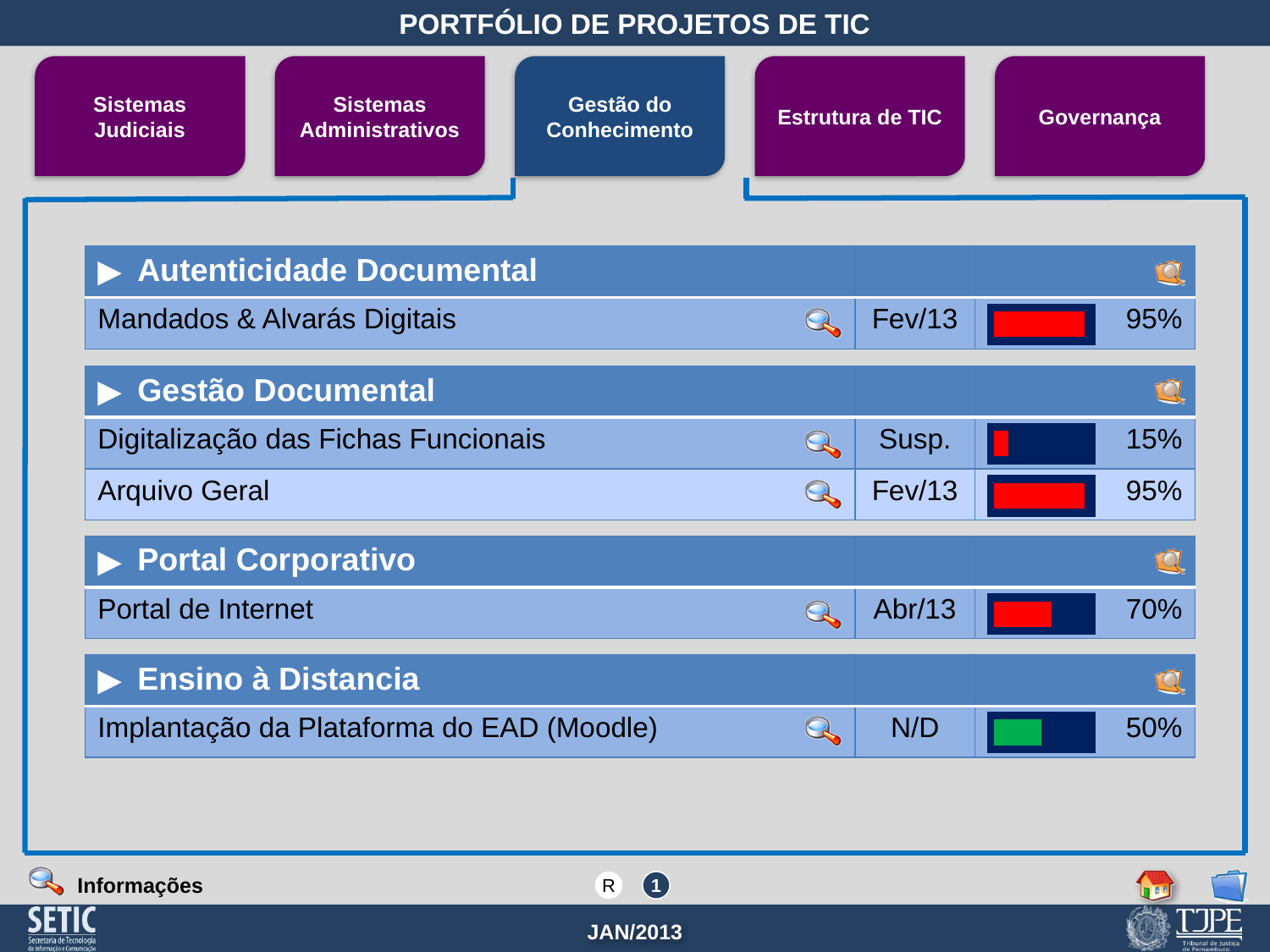
How many projects with progress bars are listed on the slide? 5 What percentage is shown for Arquivo Geral? 95% What percentage is shown for the project Mandados & Alvarás Digitais? 95% What percentage is shown for Digitalização das Fichas Funcionais? 15% What kind of chart is used to show each project's progress? Bar chart Which project has the lowest percentage on its progress bar? Digitalização das Fichas Funcionais Which has a higher percentage, Portal de Internet or Implantação da Plataforma do EAD (Moodle)? Portal de Internet What percentage is shown for Portal de Internet? 70% What percentage is shown for Implantação da Plataforma do EAD (Moodle)? 50% What is the difference in percentage between Arquivo Geral and Digitalização das Fichas Funcionais? 80% What date is shown next to Portal de Internet? Abr/13 What colour is the progress bar for Implantação da Plataforma do EAD (Moodle)? Green